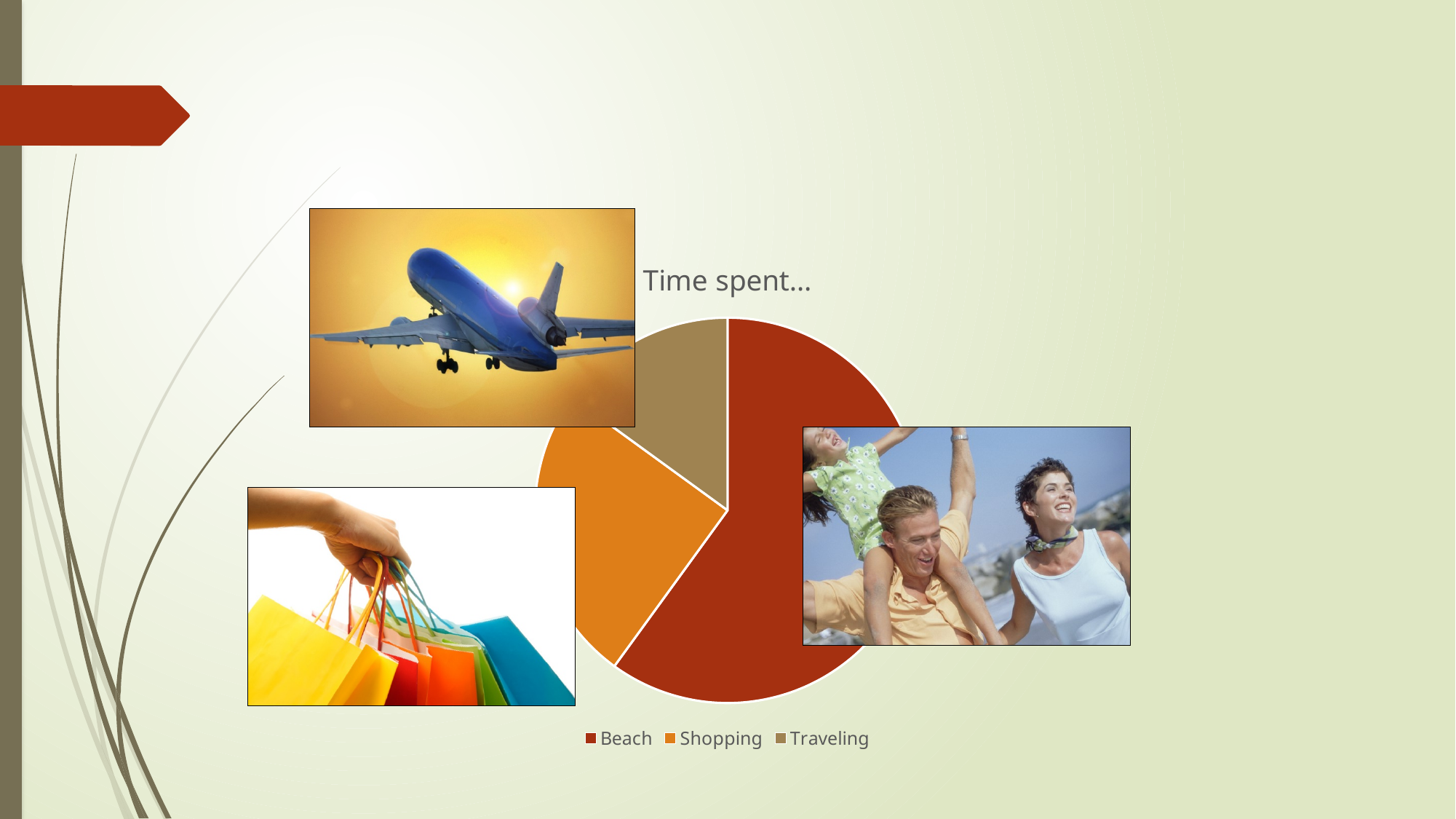
What colour is the Shopping slice in the pie chart? orange How many entries does the chart legend list? 3 What is the title of the chart? Time spent... How many slices does the pie chart have? 3 What kind of chart is shown on the slide? pie chart Which category takes up the smallest share of the pie chart? Traveling Which category takes up the largest share of the pie chart? Beach Is the Beach slice greater or less than 50% of the pie? greater Which slice is larger, Shopping or Traveling? Shopping Which slice is larger, Beach or Shopping? Beach